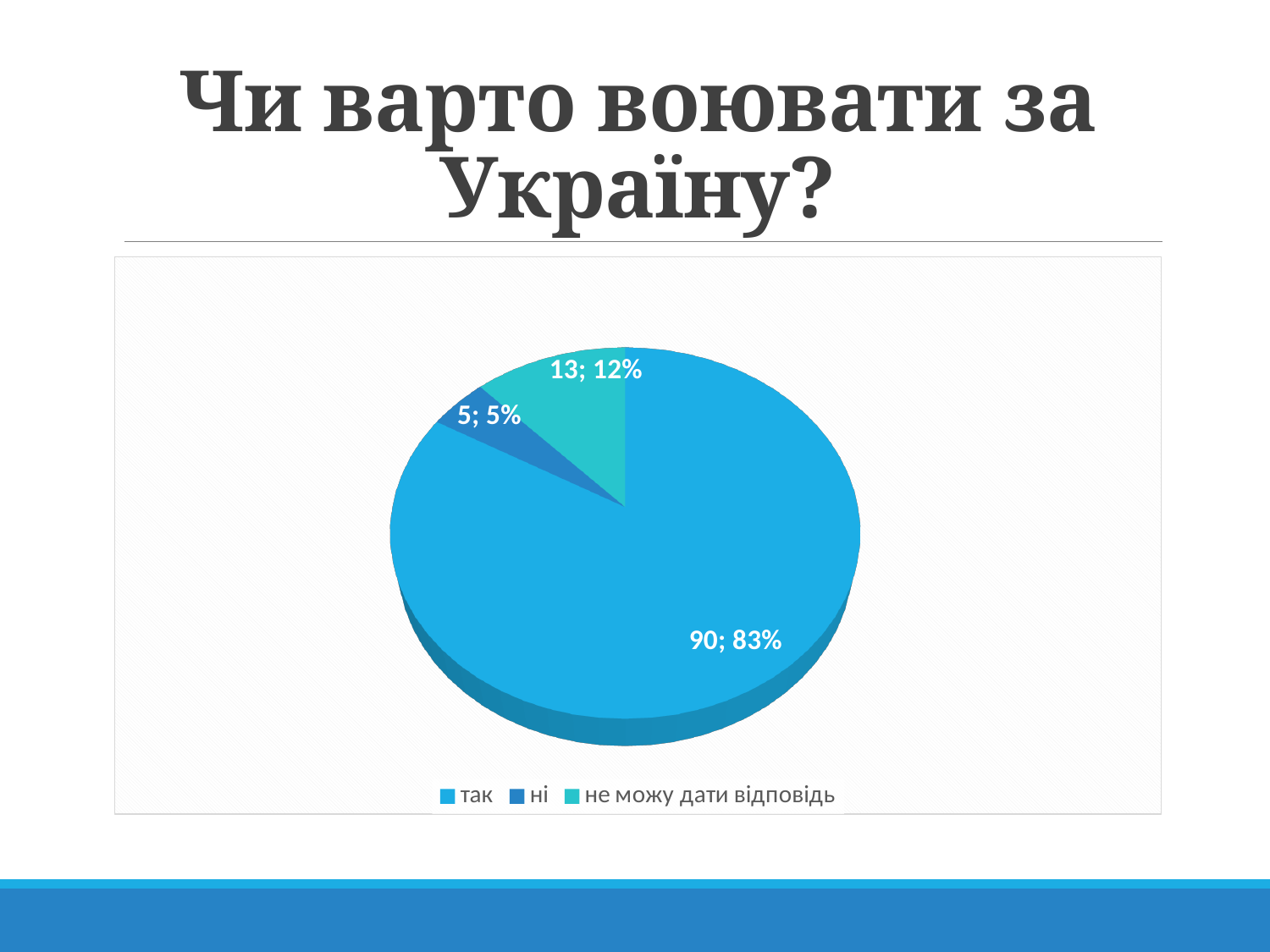
How many slices does the pie chart have? 3 What share of the pie does "так" represent? 83% How many entries does the legend list? 3 What is the value for "ні"? 5 What kind of chart is shown on the slide? pie chart What is the title of the slide above the chart? Чи варто воювати за Україну? Which category has the largest slice? так Which category has the smallest slice? ні What is the value for "так"? 90 What is the difference between the values for "так" and "не можу дати відповідь"? 77 What is the value for "не можу дати відповідь"? 13 What share of the pie does "не можу дати відповідь" represent? 12%